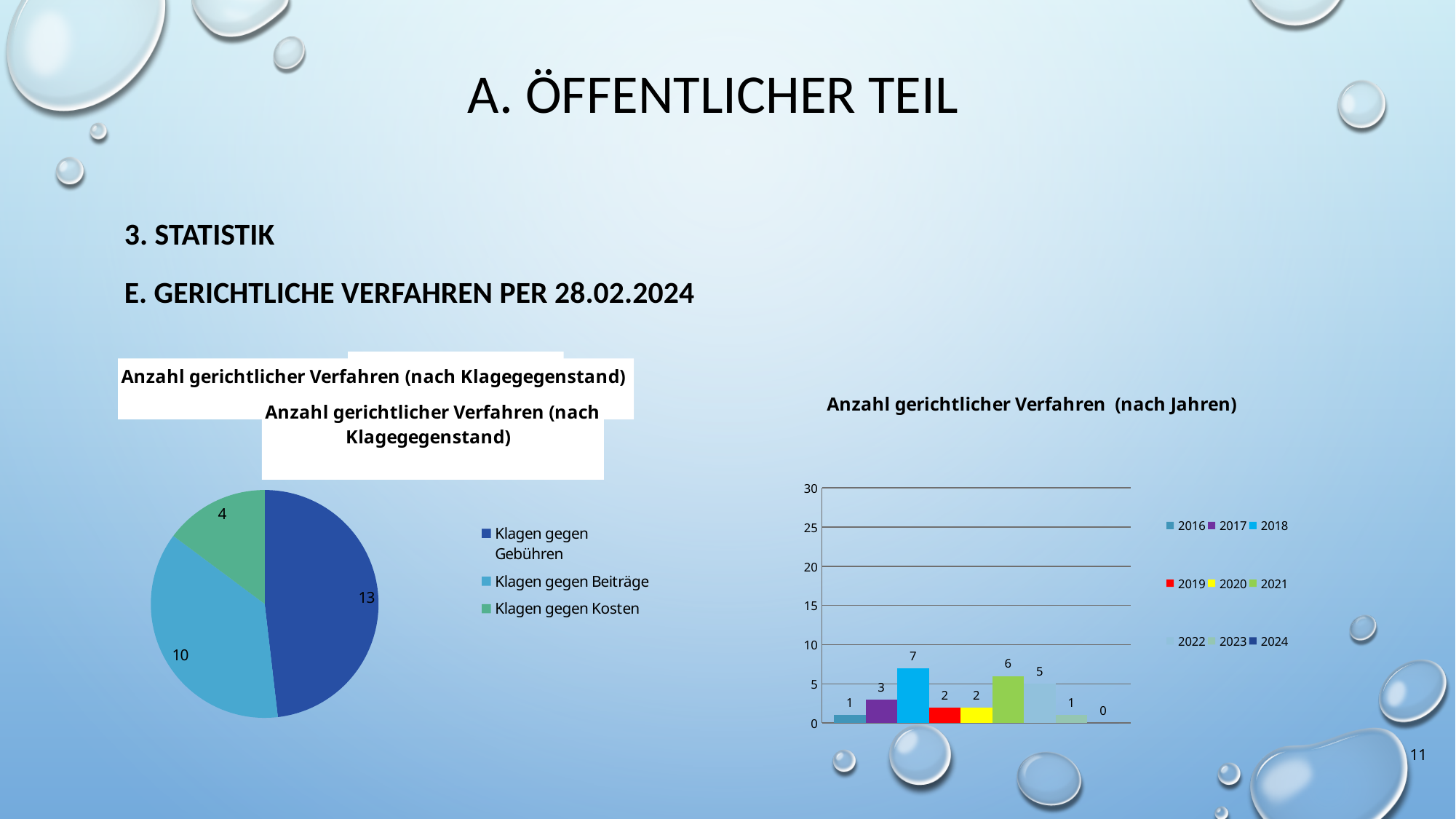
In the pie chart 'Anzahl gerichtlicher Verfahren (nach Klagegegenstand)', what is the value for 'Klagen gegen Gebühren'? 13 In the pie chart 'Anzahl gerichtlicher Verfahren (nach Klagegegenstand)', how many categories does the legend list? 3 In the pie chart 'Anzahl gerichtlicher Verfahren (nach Klagegegenstand)', what is the difference between 'Klagen gegen Gebühren' and 'Klagen gegen Beiträge'? 3 In the bar chart 'Anzahl gerichtlicher Verfahren (nach Jahren)', what is the value for 2021? 6 In the bar chart 'Anzahl gerichtlicher Verfahren (nach Jahren)', how many series does the legend list? 9 In the pie chart 'Anzahl gerichtlicher Verfahren (nach Klagegegenstand)', which category has the largest slice? Klagen gegen Gebühren What kind of chart is 'Anzahl gerichtlicher Verfahren (nach Jahren)'? Bar chart In the pie chart 'Anzahl gerichtlicher Verfahren (nach Klagegegenstand)', what is the value for 'Klagen gegen Kosten'? 4 In the bar chart 'Anzahl gerichtlicher Verfahren (nach Jahren)', which year has the lowest value? 2024 In the bar chart 'Anzahl gerichtlicher Verfahren (nach Jahren)', what is the value for 2018? 7 In the bar chart 'Anzahl gerichtlicher Verfahren (nach Jahren)', which is larger, the value for 2017 or the value for 2022? 2022 In the bar chart 'Anzahl gerichtlicher Verfahren (nach Jahren)', which year has the highest value? 2018